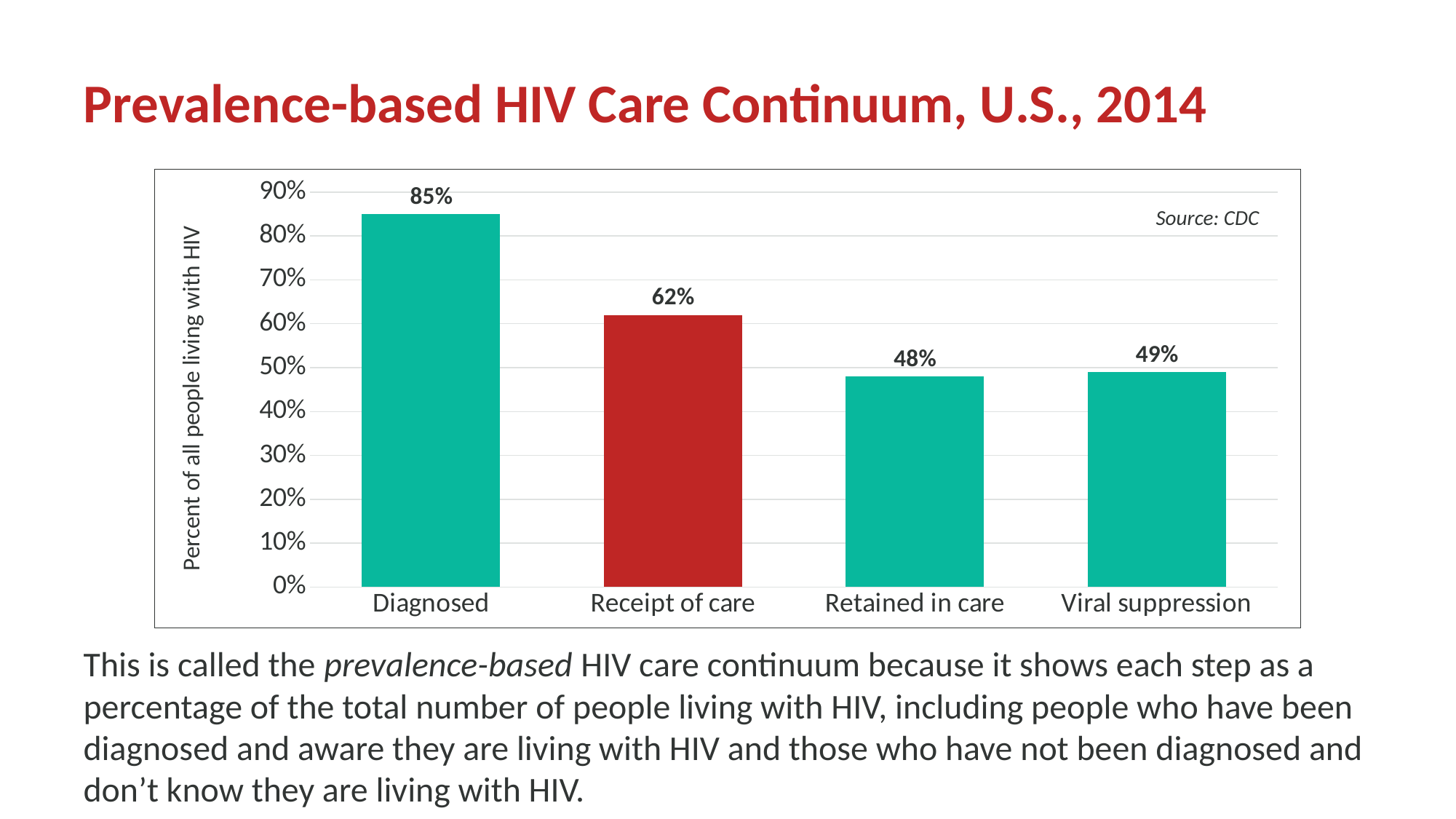
Which category has the lowest value? Retained in care Which category has the highest value? Diagnosed Which is larger, the value for Diagnosed or the value for Viral suppression? Diagnosed What kind of chart is shown on the slide? Bar chart What is the value for Viral suppression? 49% How many categories are shown on the x axis? 4 What is the difference between the Receipt of care and Retained in care values? 14% What is the value for Receipt of care? 62% What is the difference between the Diagnosed and Receipt of care values? 23% Which bar is coloured red rather than teal? Receipt of care What is the value for Retained in care? 48% What percentage of all people living with HIV were diagnosed? 85%